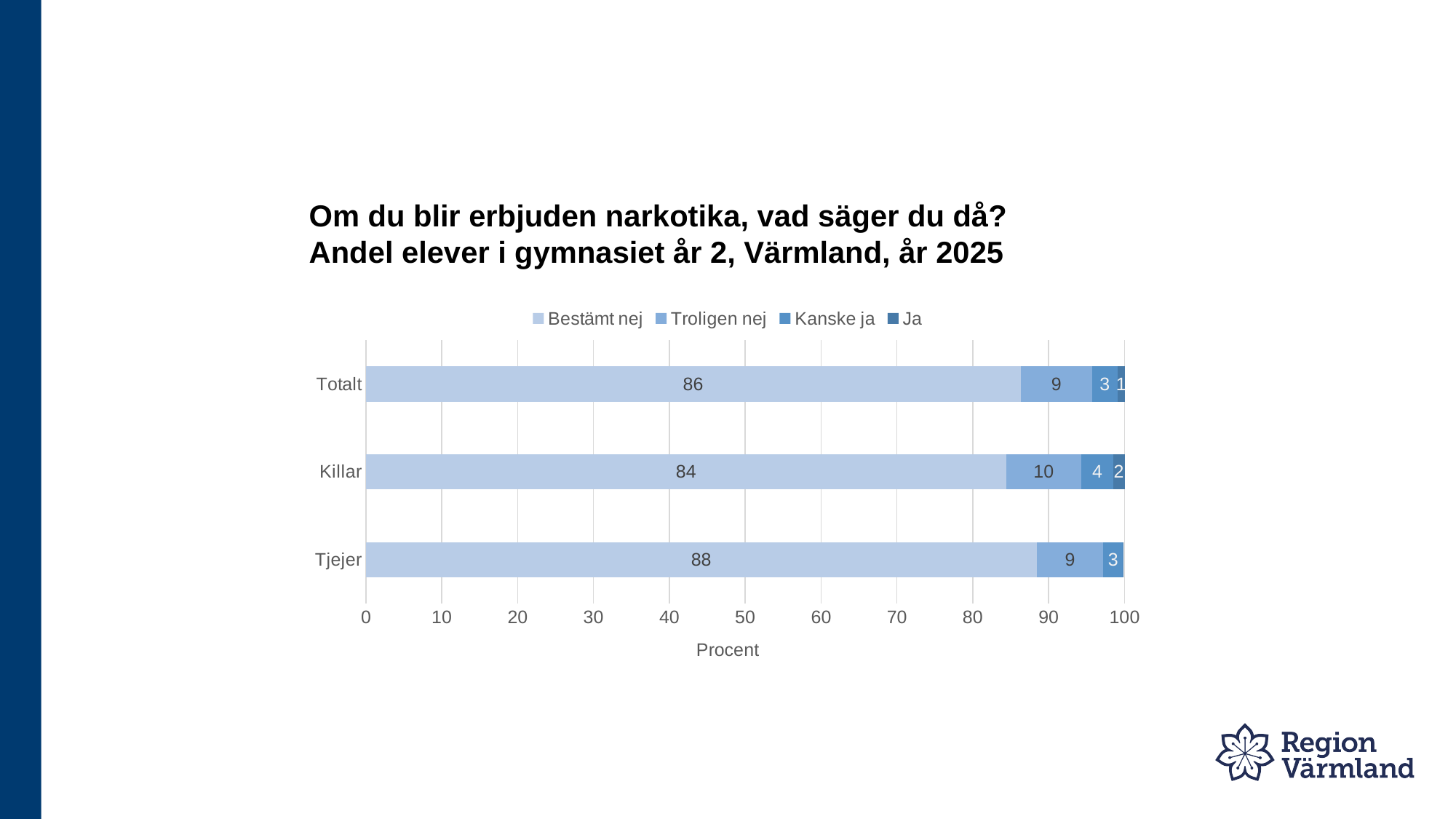
What is the value for Kanske ja for Totalt? 3 What is the value for Ja for Killar? 2 How many series does the legend list? 4 How many categories are shown on the y axis? 3 Which category has the lowest value for Bestämt nej? Killar Which has the larger Troligen nej value, Killar or Totalt? Killar What kind of chart is shown on the slide? Stacked bar chart Which category has the highest value for Bestämt nej? Tjejer What is the total of the stacked bar for Killar? 100 What is the value for Troligen nej for Killar? 10 What is the value for Bestämt nej for Killar? 84 What is the difference between the Bestämt nej values for Tjejer and Killar? 4